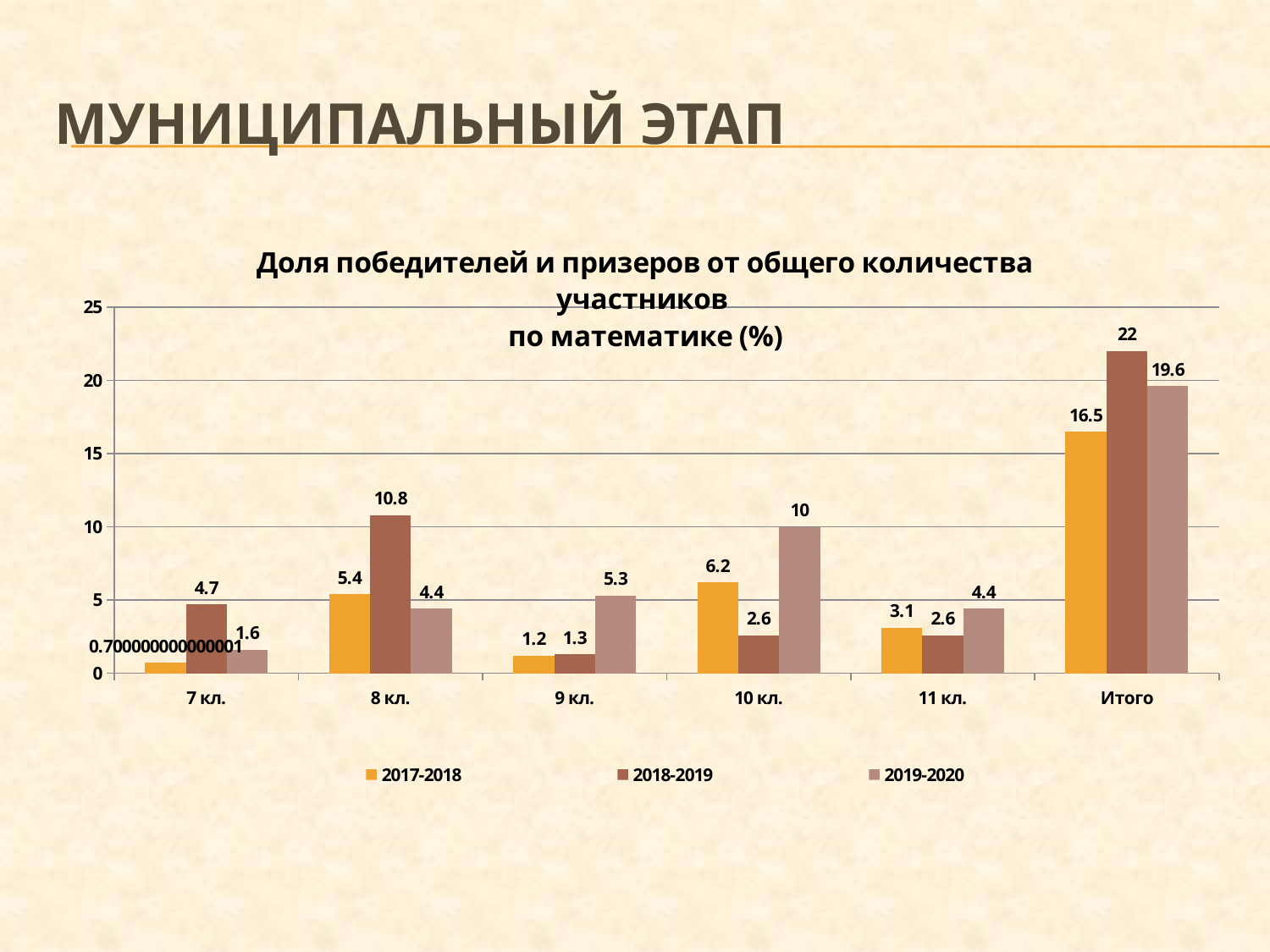
What is the value for 8 кл. in the 2018-2019 series? 10.8 Which category has the lowest value in the 2019-2020 series? 7 кл. Which category has the highest value in the 2018-2019 series? Итого Is the value for 10 кл. in the 2019-2020 series greater or less than 5? greater What kind of chart is shown on the slide? bar chart Which series is shown in orange in the legend? 2017-2018 What is the value for 10 кл. in the 2017-2018 series? 6.2 Which is larger for 9 кл.: the 2019-2020 value or the 2017-2018 value? 2019-2020 What is the difference between the 2018-2019 and 2017-2018 values for Итого? 5.5 What is the value for Итого in the 2019-2020 series? 19.6 How many categories are shown on the x axis? 6 How many series does the legend list? 3